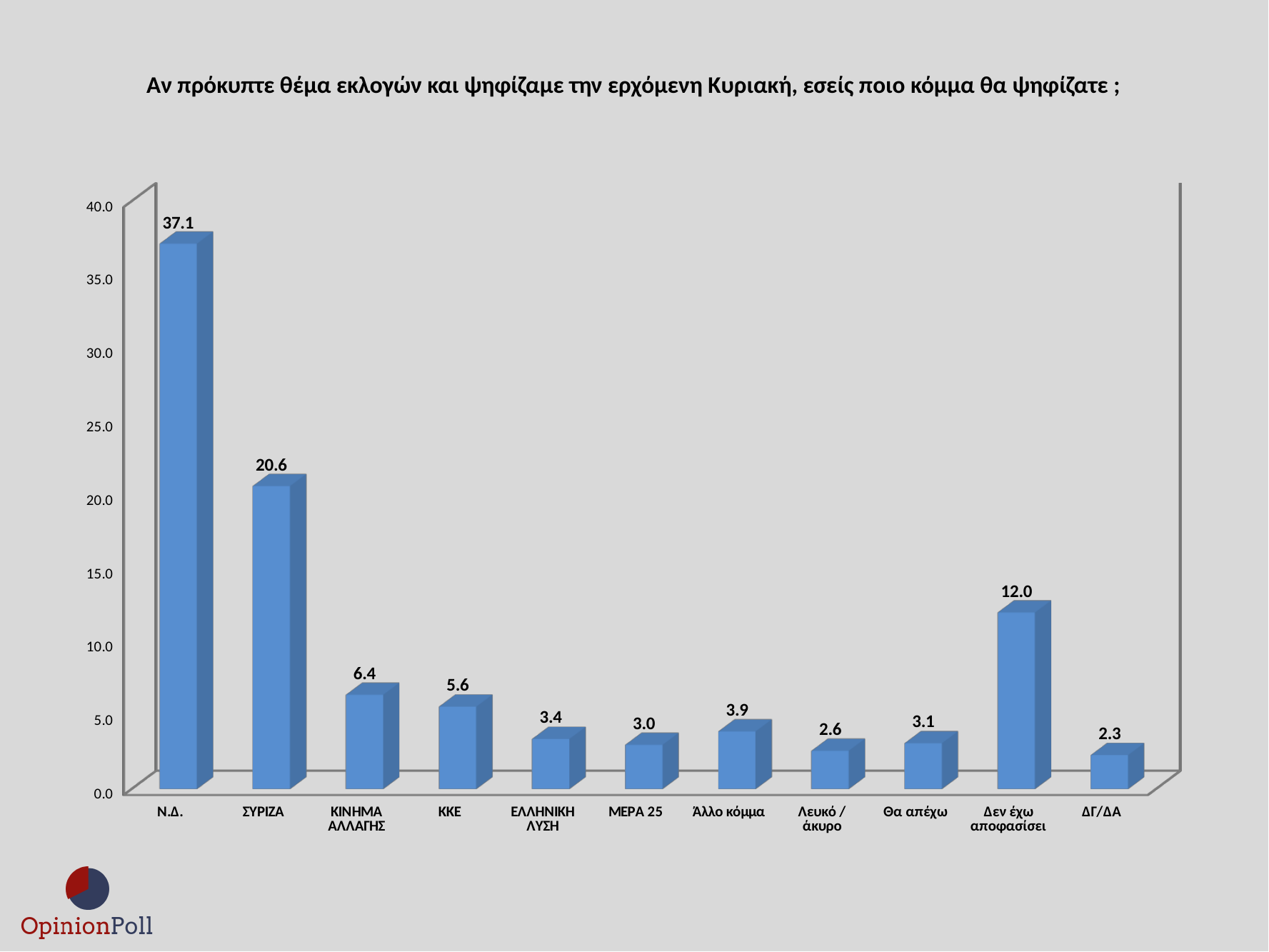
Is the value for ΣΥΡΙΖΑ greater or less than 25.0? less What is the value for ΣΥΡΙΖΑ? 20.6 Which category has the lowest value? ΔΓ/ΔΑ What is the value for ΚΚΕ? 5.6 How many categories are shown on the x axis? 11 Which category has the highest value? Ν.Δ. Which is larger, the value for ΚΙΝΗΜΑ ΑΛΛΑΓΗΣ or the value for ΚΚΕ? ΚΙΝΗΜΑ ΑΛΛΑΓΗΣ What is the value for Ν.Δ.? 37.1 What is the difference between the values for Άλλο κόμμα and Λευκό / άκυρο? 1.3 What is the value for Δεν έχω αποφασίσει? 12.0 What is the difference between the values for Ν.Δ. and ΣΥΡΙΖΑ? 16.5 What kind of chart is shown on the slide? bar chart